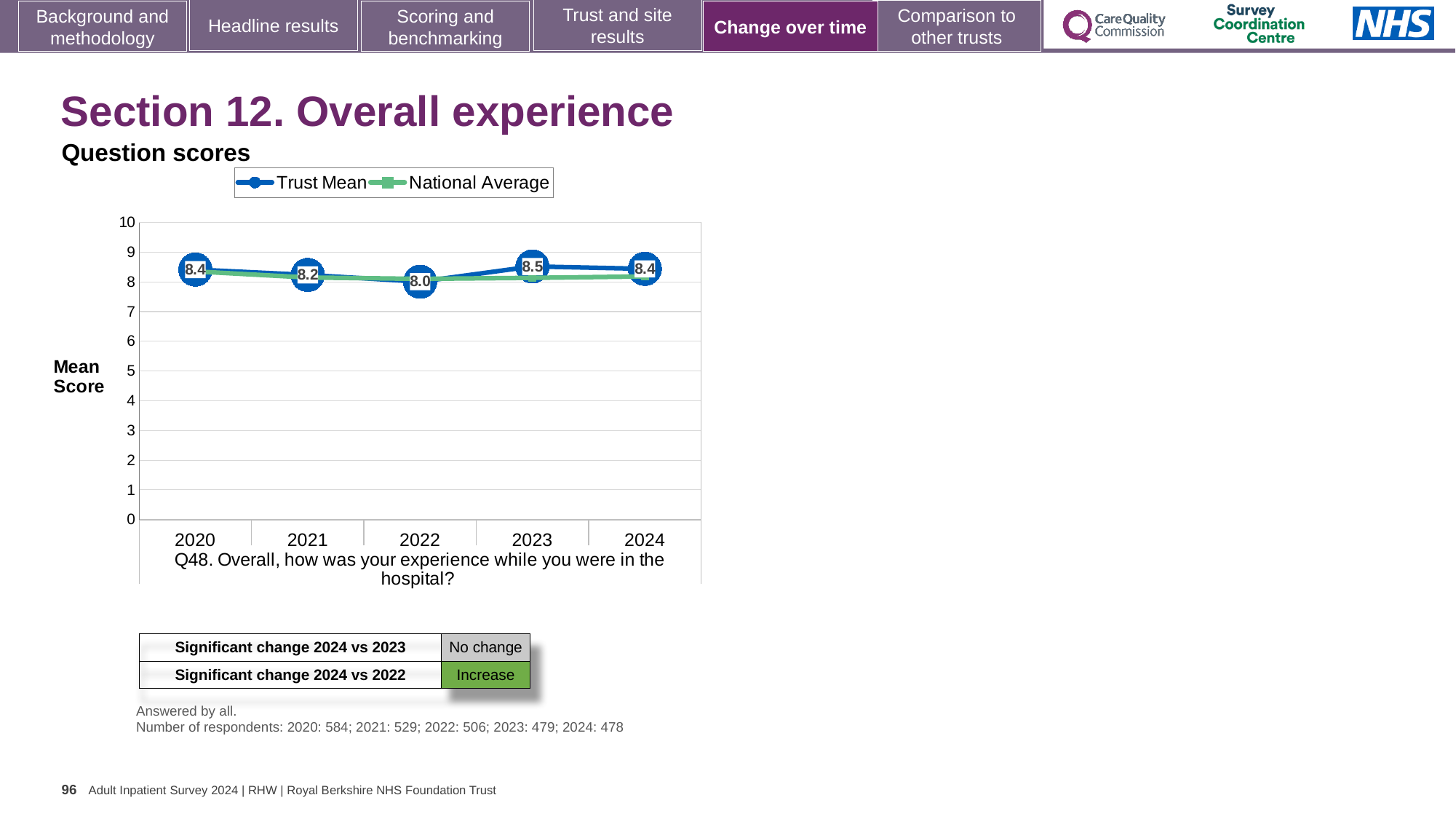
What is the Trust Mean score for 2020? 8.4 How many series does the legend list? 2 Does the Trust Mean score rise or fall from 2022 to 2023? Rise In which year is the Trust Mean score highest? 2023 How many years are plotted on the x axis? 5 What is the Trust Mean score for 2023? 8.5 In which year is the Trust Mean score lowest? 2022 Is the National Average value for 2022 greater or less than 5? greater What is the Trust Mean score for 2022? 8.0 Which year has the larger Trust Mean score, 2020 or 2021? 2020 What is the difference between the Trust Mean scores for 2023 and 2022? 0.5 What kind of chart is shown? Line chart